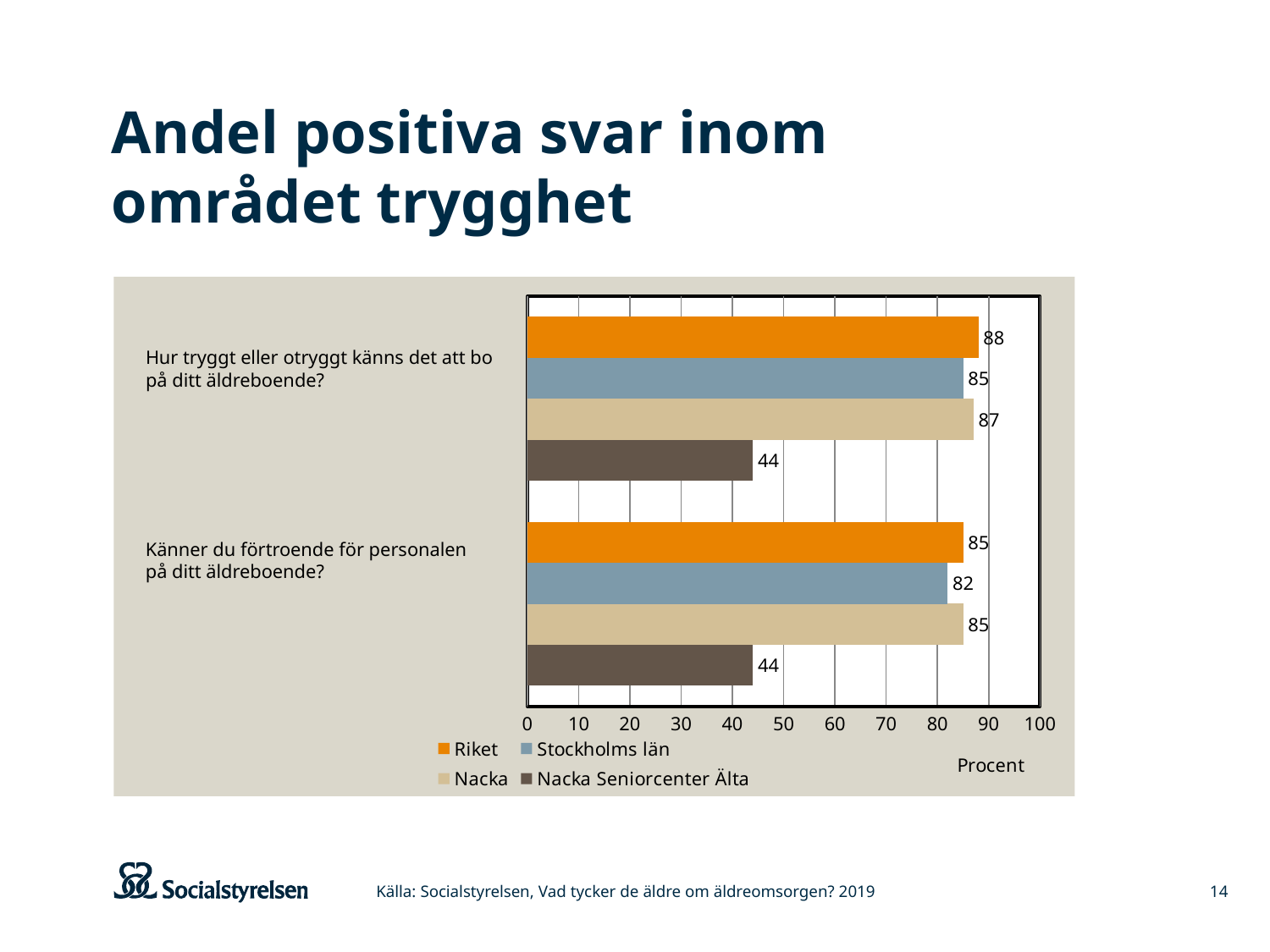
Which series has the highest value on the question "Hur tryggt eller otryggt känns det att bo på ditt äldreboende?"? Riket Which is larger on the question "Hur tryggt eller otryggt känns det att bo på ditt äldreboende?": the value for Nacka or the value for Stockholms län? Nacka How many series does the legend list? 4 What is the value for Stockholms län on the question "Känner du förtroende för personalen på ditt äldreboende?"? 82 What unit is shown on the horizontal axis of the chart? Procent Which series has the lowest value on the question "Känner du förtroende för personalen på ditt äldreboende?"? Nacka Seniorcenter Älta What is the difference between the Riket value and the Nacka Seniorcenter Älta value on the question "Hur tryggt eller otryggt känns det att bo på ditt äldreboende?"? 44 What is the value for Riket on the question "Hur tryggt eller otryggt känns det att bo på ditt äldreboende?"? 88 What is the value for Nacka on the question "Känner du förtroende för personalen på ditt äldreboende?"? 85 What kind of chart is shown on the slide? Bar chart What is the difference between the Riket value and the Stockholms län value on the question "Känner du förtroende för personalen på ditt äldreboende?"? 3 What is the value for Nacka Seniorcenter Älta on the question "Hur tryggt eller otryggt känns det att bo på ditt äldreboende?"? 44